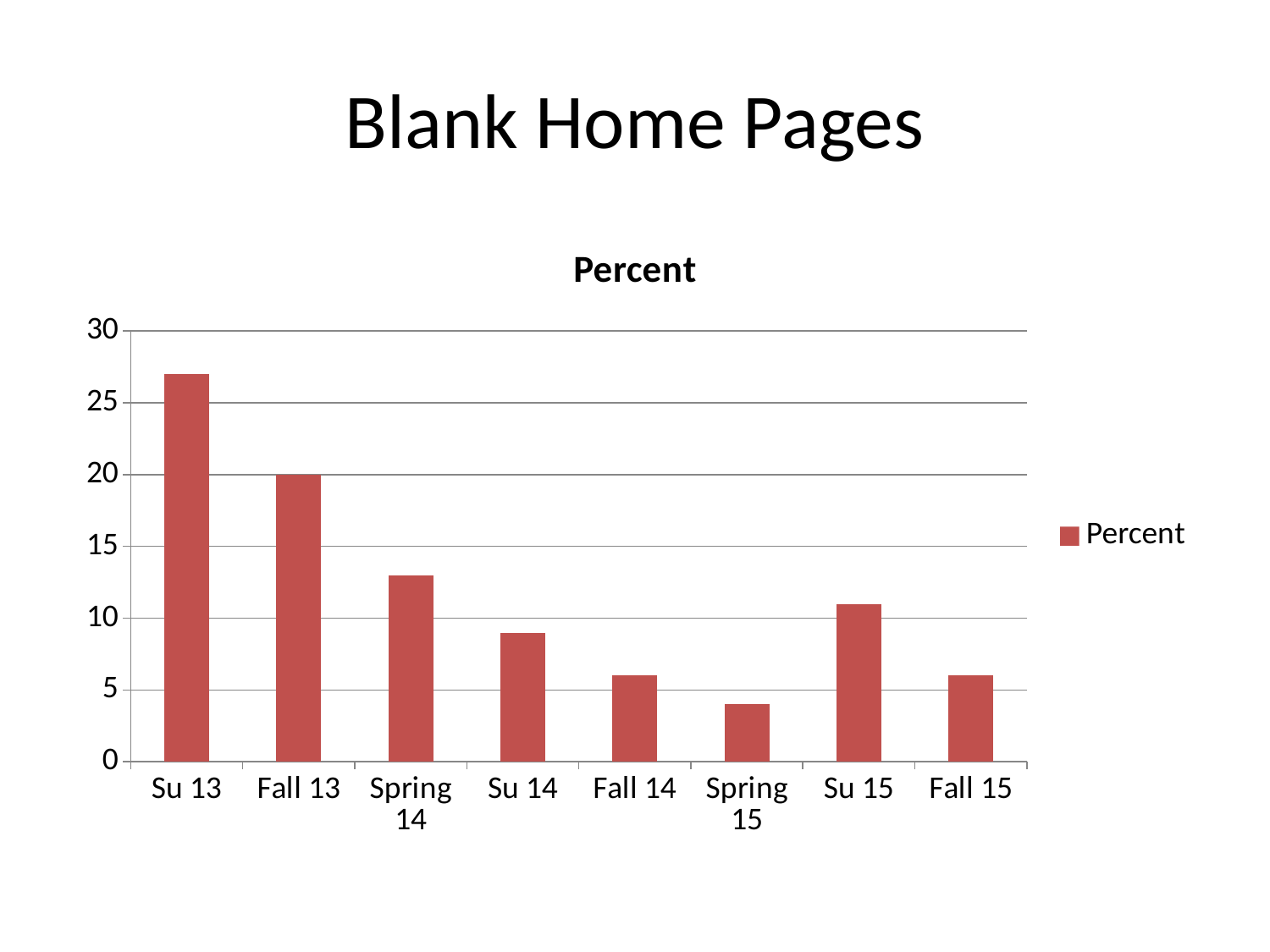
How many categories are shown on the x axis of the chart? 8 Which category has the lowest value? Spring 15 What type of chart is shown on the slide? bar chart What is the value for Fall 13? 20 Is the value for Spring 14 greater or less than 15? less Do the values rise or fall from Su 13 to Spring 15? fall What is the title of the chart? Percent Is the value for Su 13 greater or less than 25? greater How many series does the legend list? 1 Is the value for Su 15 greater or less than 10? greater Which is larger, the value for Su 13 or the value for Fall 13? Su 13 Which category has the highest value? Su 13